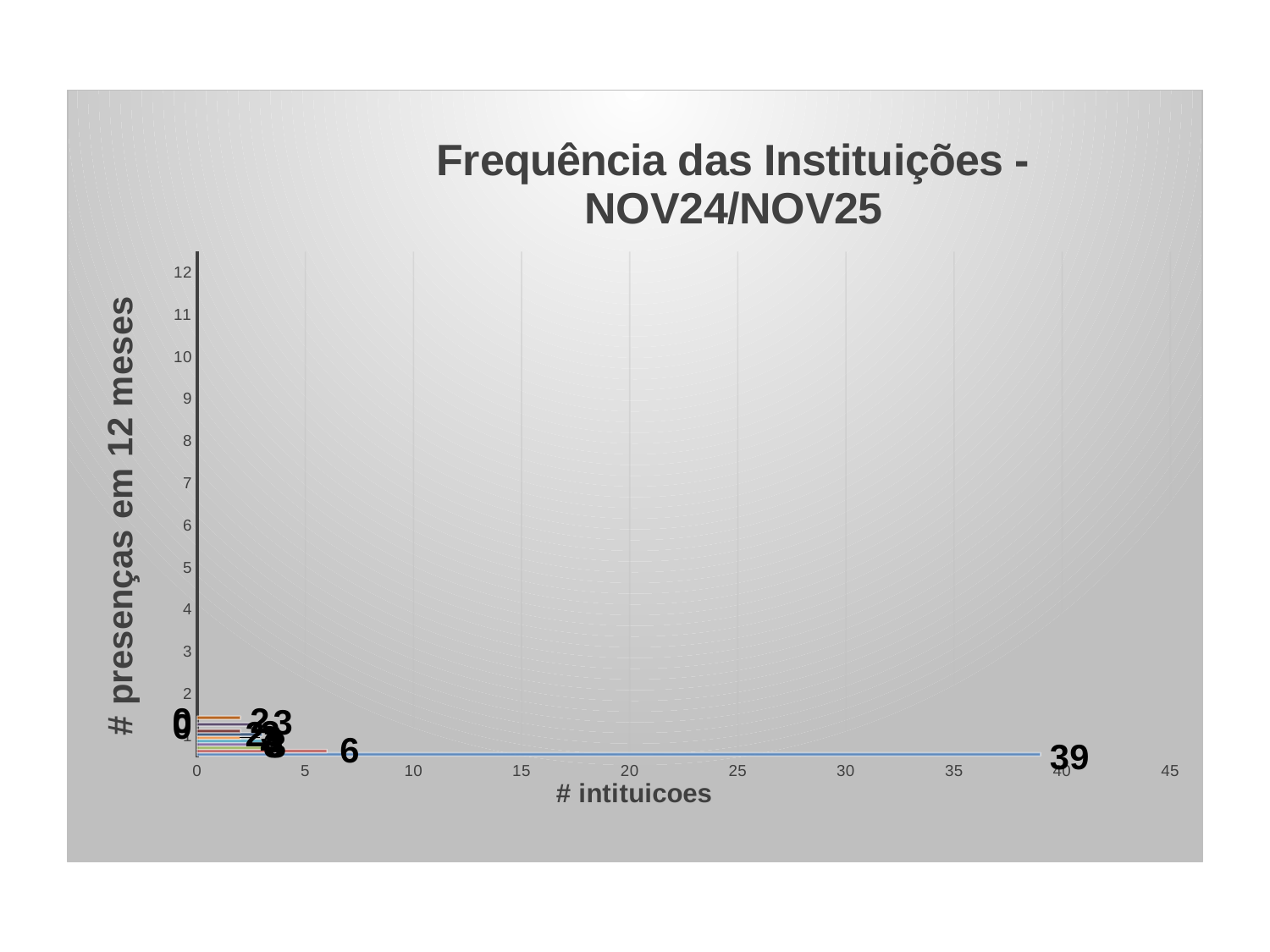
What is the title of the chart? Frequência das Instituições - NOV24/NOV25 What is the highest tick value shown on the horizontal axis? 45 What is the value labelled on the second-longest bar in the chart? 6 What is the label of the horizontal axis? # intituicoes Is the value of the bar labelled 6 greater or less than 10? less What kind of chart is shown on the slide? bar chart Which is larger: the bar labelled 39 or the bar labelled 6? the bar labelled 39 What is the largest value labelled on any bar in the chart? 39 What is the difference between the longest bar's value (39) and the second-longest bar's value (6)? 33 Is the value of the longest bar greater or less than 35? greater